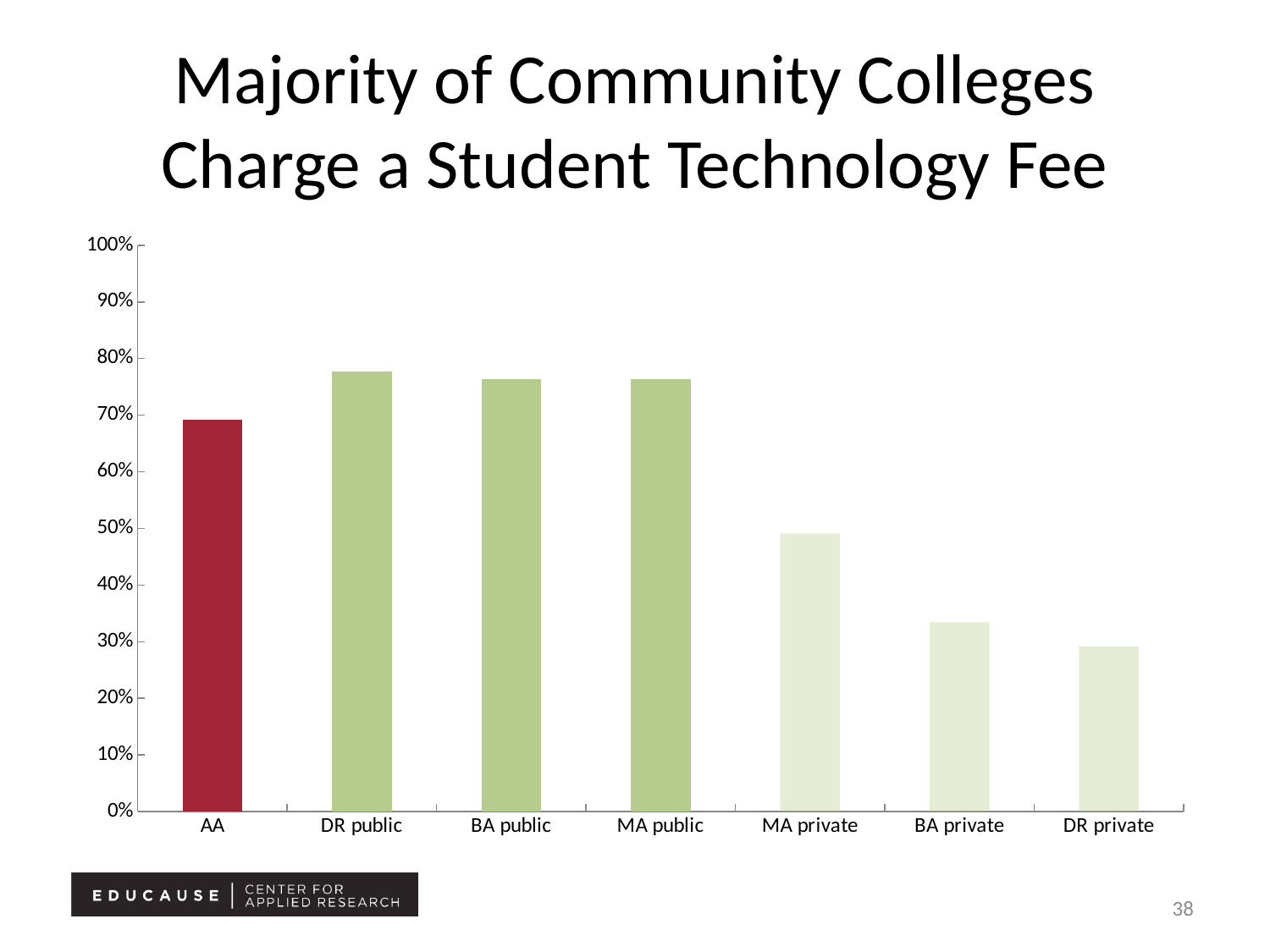
What kind of chart is shown on the slide? bar chart What is the title of the slide containing the chart? Majority of Community Colleges Charge a Student Technology Fee Is the value for BA public greater or less than 70%? greater Which is larger, the value for BA private or the value for MA private? MA private Which category has the lowest value in the chart? DR private Moving from DR public to DR private along the x axis, do the values rise or fall? fall Is the value for AA greater or less than 60%? greater How many categories are shown on the x axis of the chart? 7 Is the value for DR private greater or less than 40%? less Which is larger, the value for AA or the value for MA private? AA